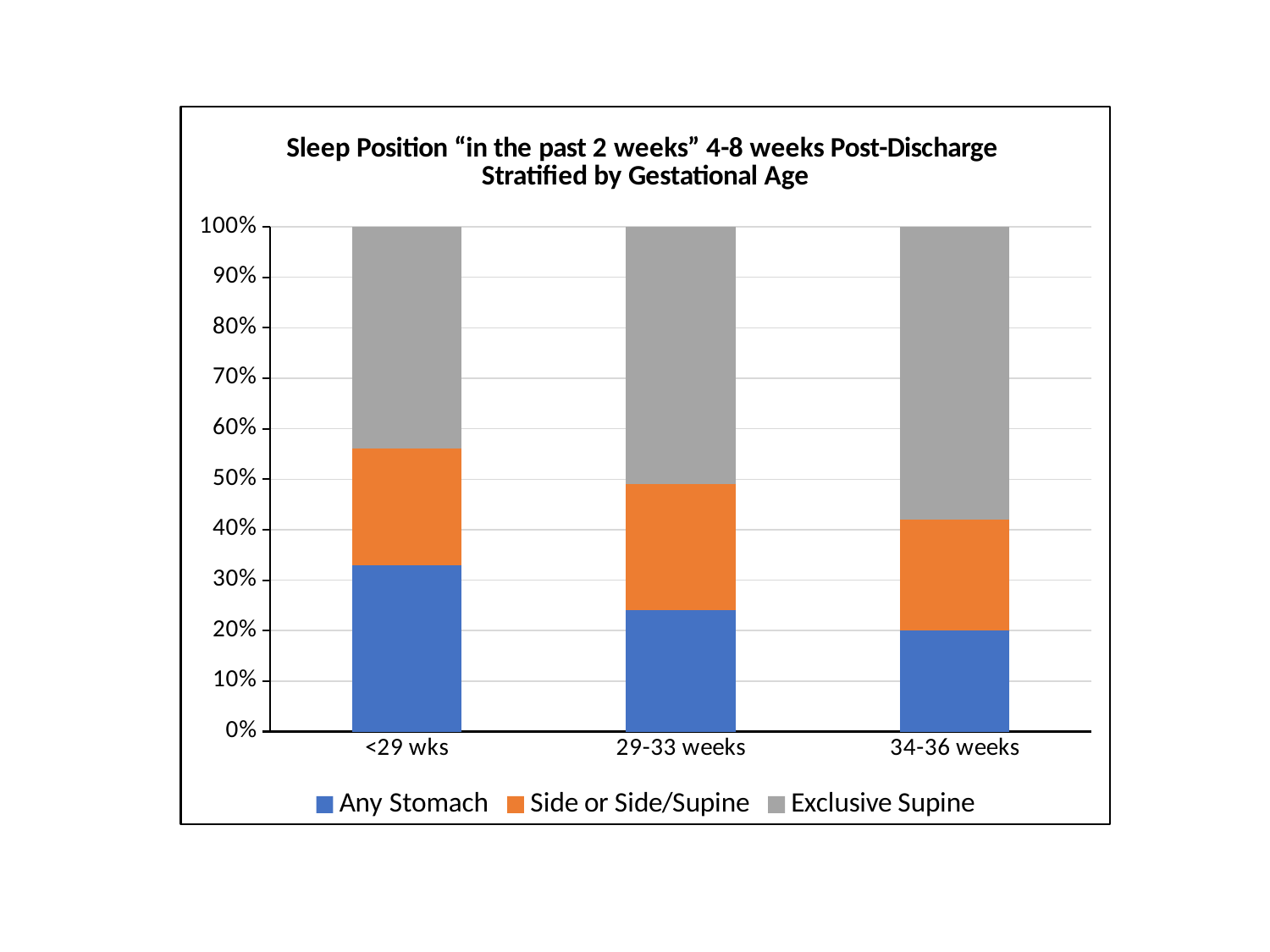
Does the Any Stomach share rise or fall as gestational age increases along the x axis? Fall What is the total of each stacked bar? 100% Is the Any Stomach value for <29 wks greater or less than 30%? greater Is the Any Stomach value for 29-33 weeks greater or less than 30%? less Which has a larger Any Stomach share, <29 wks or 34-36 weeks? <29 wks Which gestational age category has the smallest Any Stomach share? 34-36 weeks How many gestational age categories are shown on the x axis? 3 Is the Exclusive Supine share for 34-36 weeks greater or less than 50%? greater Which gestational age category has the largest Any Stomach share? <29 wks What kind of chart is shown on the slide? Stacked bar chart How many series does the legend list? 3 Which has a larger Exclusive Supine share, <29 wks or 34-36 weeks? 34-36 weeks